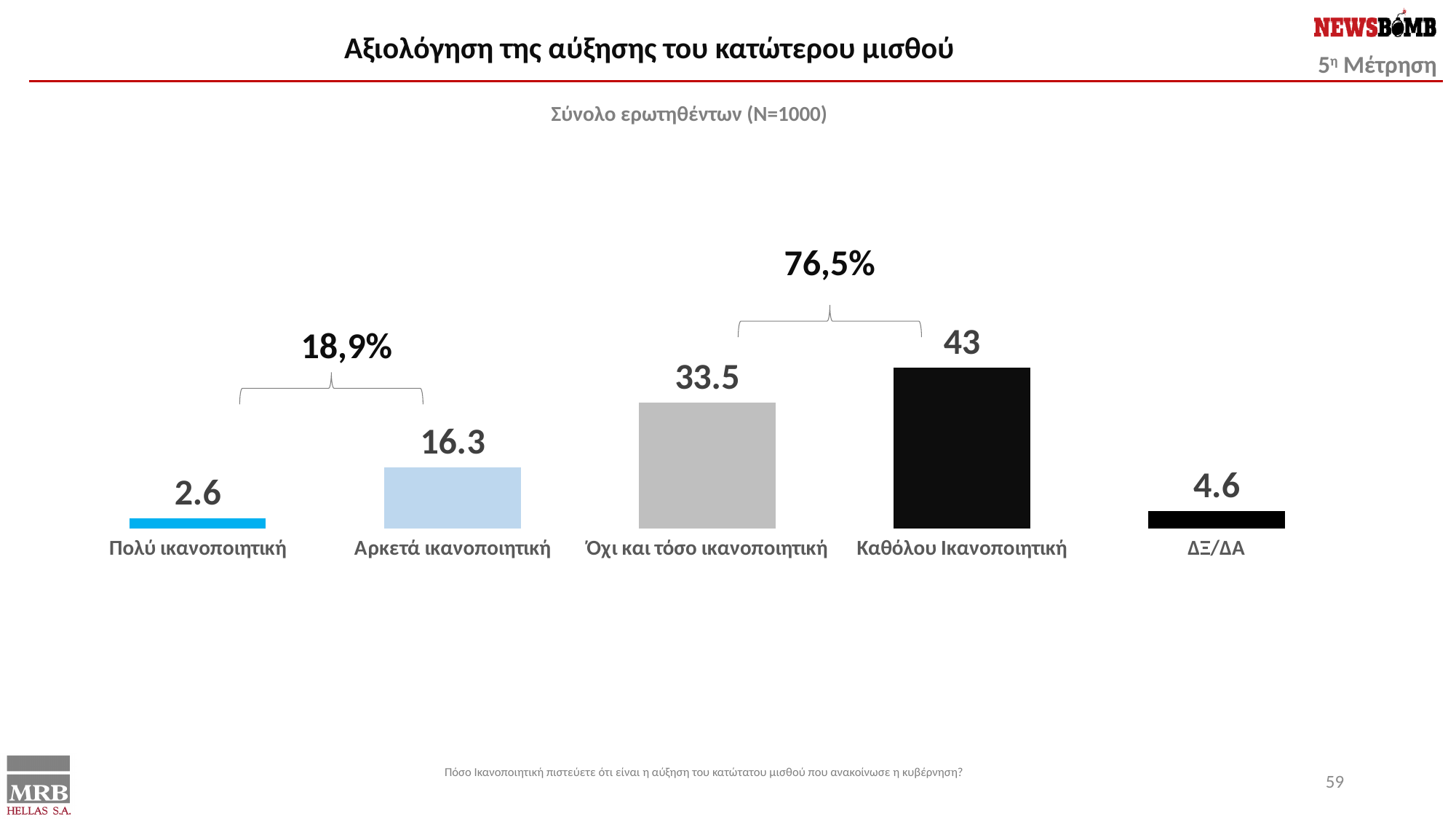
What is the value for Καθόλου Ικανοποιητική? 43 What kind of chart is shown on the slide? bar chart What is the value for Αρκετά ικανοποιητική? 16.3 How many categories are shown in the chart? 5 What is the value for Όχι και τόσο ικανοποιητική? 33.5 What combined percentage is shown above the bracket grouping Όχι και τόσο ικανοποιητική and Καθόλου Ικανοποιητική? 76,5% Which category has the highest value? Καθόλου Ικανοποιητική Which category has the lowest value? Πολύ ικανοποιητική What is the value for Πολύ ικανοποιητική? 2.6 Which is larger, the value for Αρκετά ικανοποιητική or the value for ΔΞ/ΔΑ? Αρκετά ικανοποιητική What is the value for ΔΞ/ΔΑ? 4.6 What is the difference between the values for Καθόλου Ικανοποιητική and Όχι και τόσο ικανοποιητική? 9.5